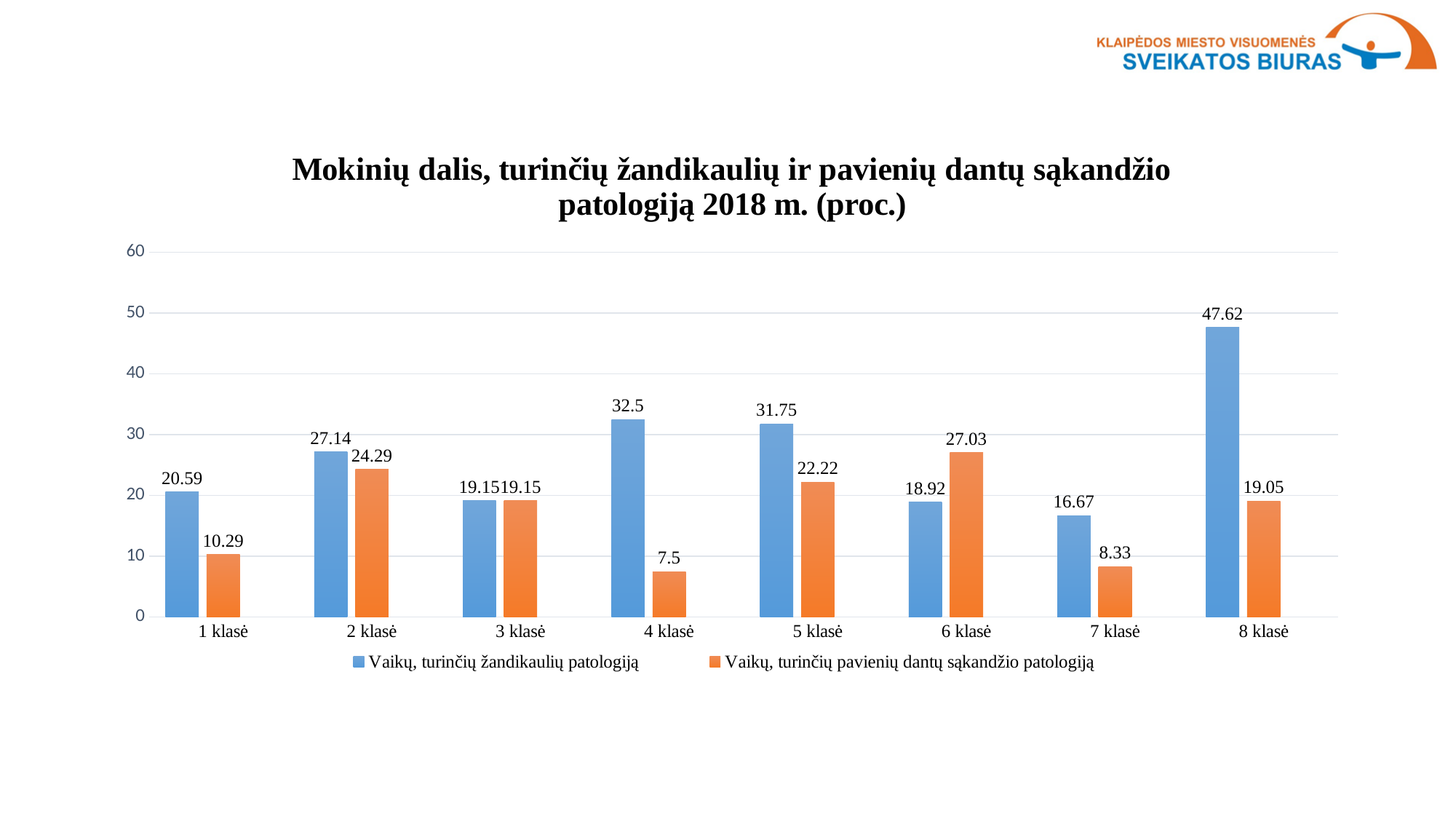
What is the value for 4 klasė in the series 'Vaikų, turinčių pavienių dantų sąkandžio patologiją'? 7.5 How many series does the legend list? 2 What is the difference between the two series' values for 1 klasė? 10.3 What is the value for 6 klasė in the series 'Vaikų, turinčių pavienių dantų sąkandžio patologiją'? 27.03 Which class has the highest value in the series 'Vaikų, turinčių žandikaulių patologiją'? 8 klasė How many classes (categories) are shown on the x axis? 8 Which class has the lowest value in the series 'Vaikų, turinčių žandikaulių patologiją'? 7 klasė What kind of chart is shown on the slide? Bar chart What is the value for 8 klasė in the series 'Vaikų, turinčių žandikaulių patologiją'? 47.62 Is the value for 5 klasė in the series 'Vaikų, turinčių žandikaulių patologiją' greater or less than 30? greater For 6 klasė, which series has the larger value? Vaikų, turinčių pavienių dantų sąkandžio patologiją Which class has the lowest value in the series 'Vaikų, turinčių pavienių dantų sąkandžio patologiją'? 4 klasė